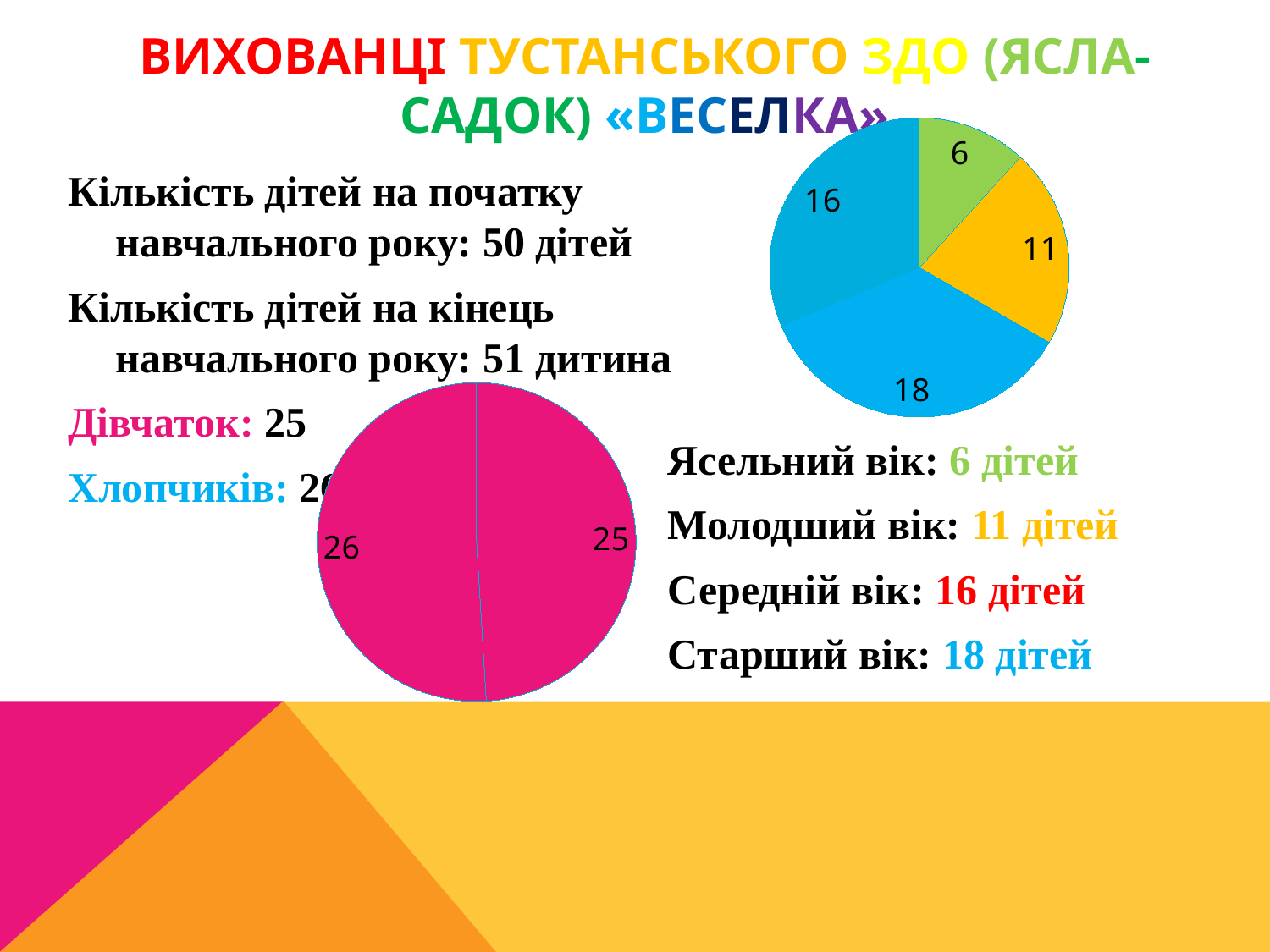
In the bottom-left pie chart, which slice is larger, 26 or 25? 26 What kind of chart is the chart in the top-right of the slide? pie chart In the bottom-left pie chart, what is the difference between the two slices? 1 In the top-right pie chart, what is the value of the green slice? 6 In the top-right pie chart, what is the total of all four slices? 51 What kind of chart is the chart in the bottom-left of the slide? pie chart In the top-right pie chart, what is the difference between the largest slice (18) and the smallest slice (6)? 12 In the top-right pie chart, what is the value of the yellow slice? 11 In the bottom-left pie chart, how many slices are there? 2 In the top-right pie chart, which slice has the largest value? 18 In the top-right pie chart, how many slices are there? 4 In the top-right pie chart, which slice has the smallest value? 6